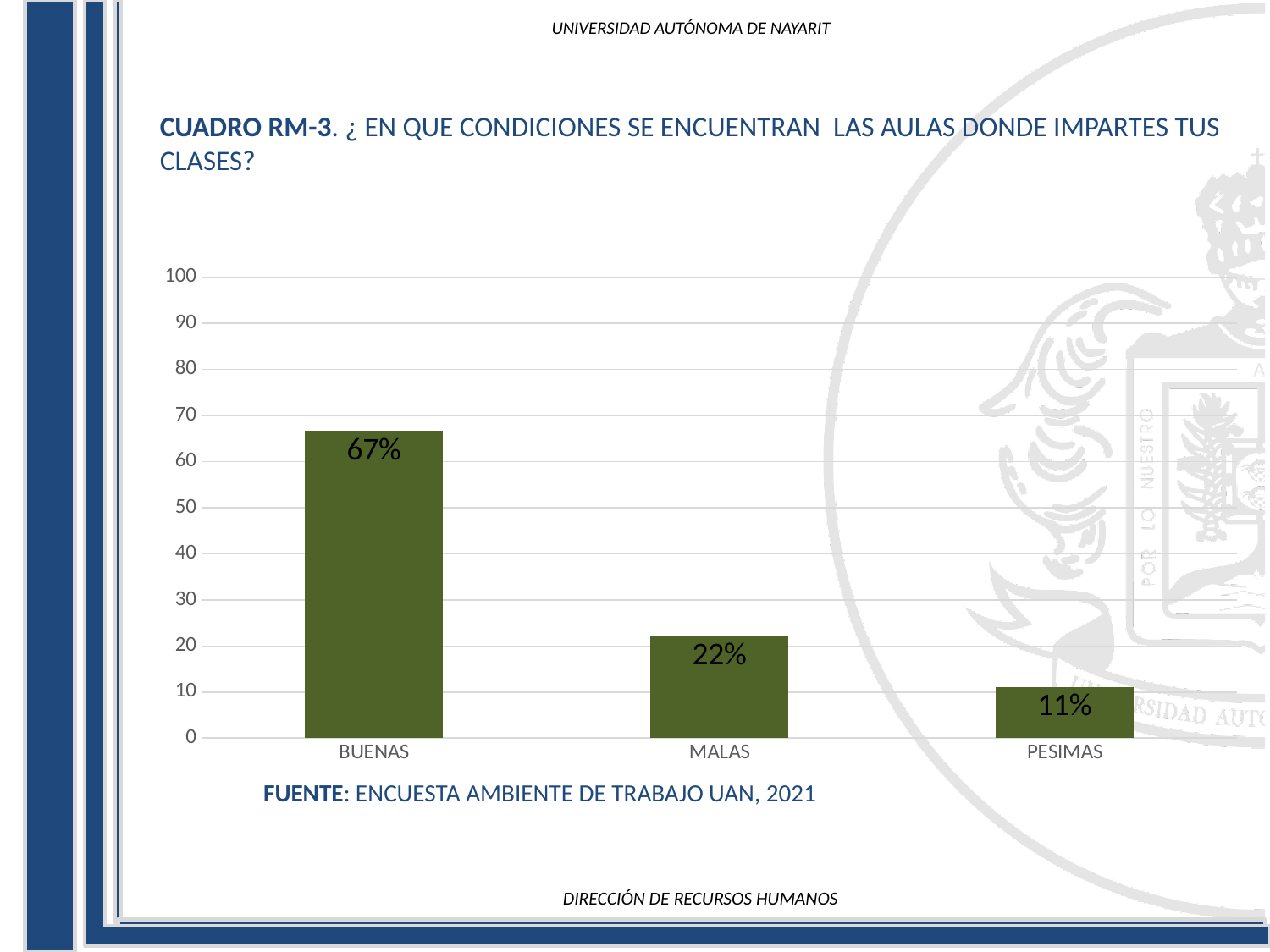
What is the difference between the values for MALAS and PESIMAS? 11% What is the difference between the values for BUENAS and MALAS? 45% Is the value for BUENAS greater or less than 50? greater How many categories are shown on the x axis? 3 What is the value for MALAS? 22% What kind of chart is shown on the slide? bar chart Which category has the highest value? BUENAS What source is cited below the chart? ENCUESTA AMBIENTE DE TRABAJO UAN, 2021 What is the value for BUENAS? 67% What is the value for PESIMAS? 11% Which category has the lowest value? PESIMAS Which is larger, the value for MALAS or the value for PESIMAS? MALAS